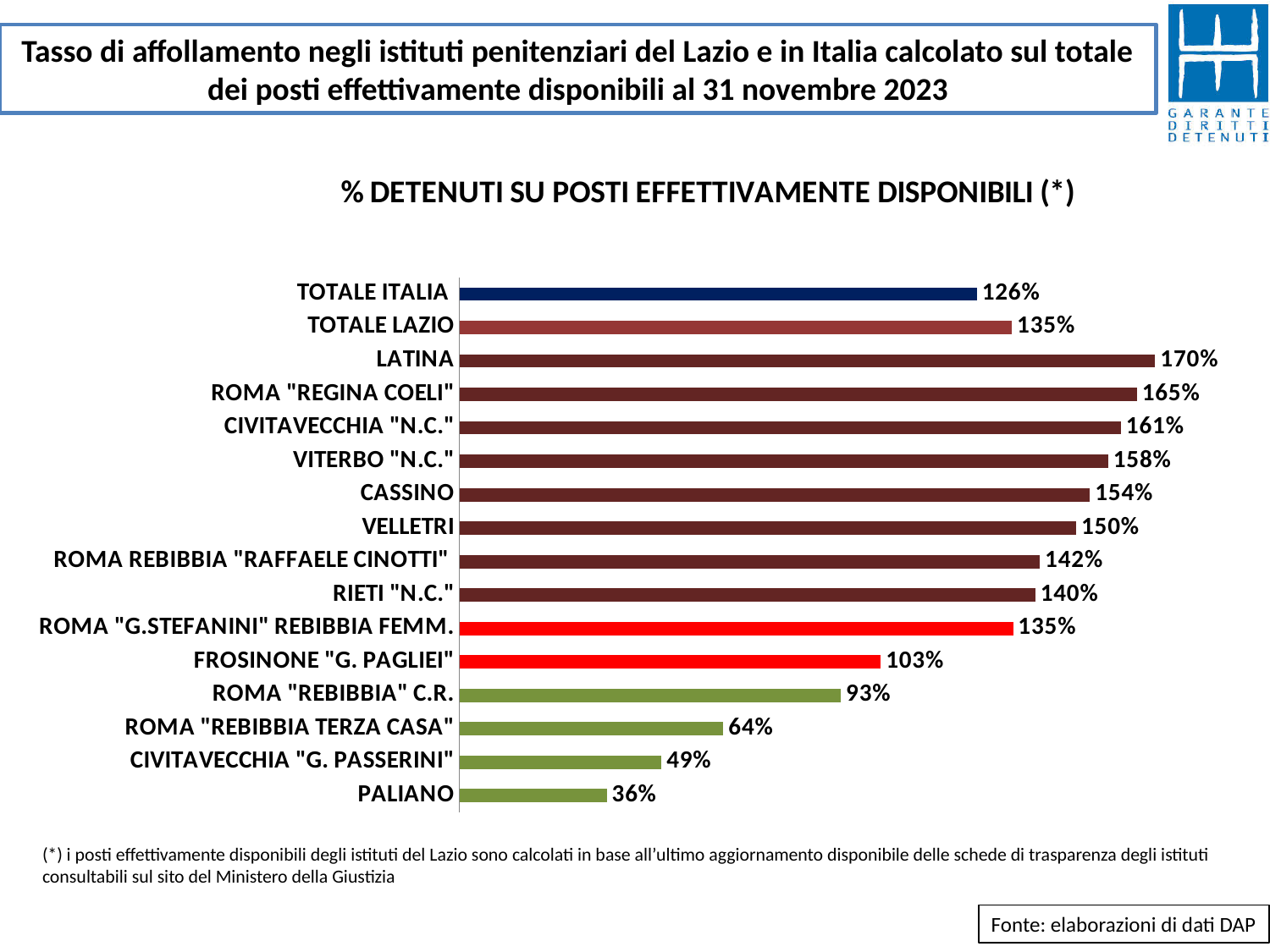
What is the difference between the values for TOTALE LAZIO and TOTALE ITALIA? 9% Which category has the highest value? LATINA What is the value for TOTALE ITALIA? 126% What is the value for PALIANO? 36% Which category has the lowest value? PALIANO How many categories are shown in the chart? 16 What is the difference between the values for ROMA "REBIBBIA" C.R. and ROMA "REBIBBIA TERZA CASA"? 29% What is the value for FROSINONE "G. PAGLIEI"? 103% Which is larger, the value for CASSINO or the value for VELLETRI? CASSINO What kind of chart is shown on the slide? Bar chart What is the value for LATINA? 170% What is the title of the chart? % DETENUTI SU POSTI EFFETTIVAMENTE DISPONIBILI (*)